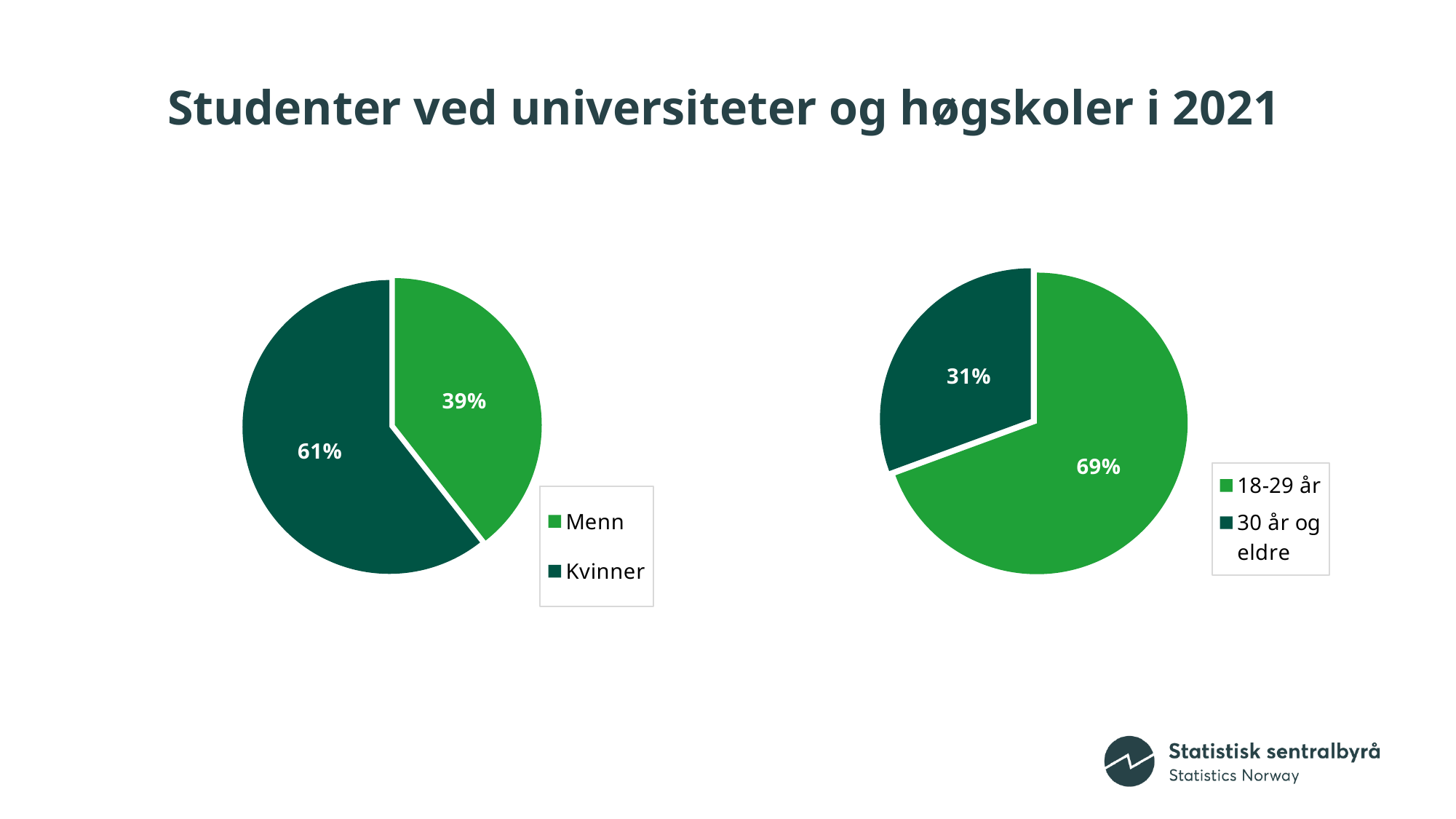
In the right pie chart (age groups), which is larger: 18-29 år or 30 år og eldre? 18-29 år What kind of chart is the left chart (Menn/Kvinner)? Pie chart In the left pie chart (Menn/Kvinner), what share is Menn? 39% What is the title of the slide? Studenter ved universiteter og høgskoler i 2021 In the left pie chart (Menn/Kvinner), which slice is the largest? Kvinner In the right pie chart (age groups), what share is 30 år og eldre? 31% In the right pie chart (age groups), what share is 18-29 år? 69% In the left pie chart (Menn/Kvinner), what share is Kvinner? 61% How many slices does the right pie chart (age groups) have? 2 In the right pie chart (age groups), which slice is the smallest? 30 år og eldre In the left pie chart (Menn/Kvinner), what is the difference in percentage points between Kvinner and Menn? 22 In the right pie chart (age groups), what is the difference in percentage points between 18-29 år and 30 år og eldre? 38